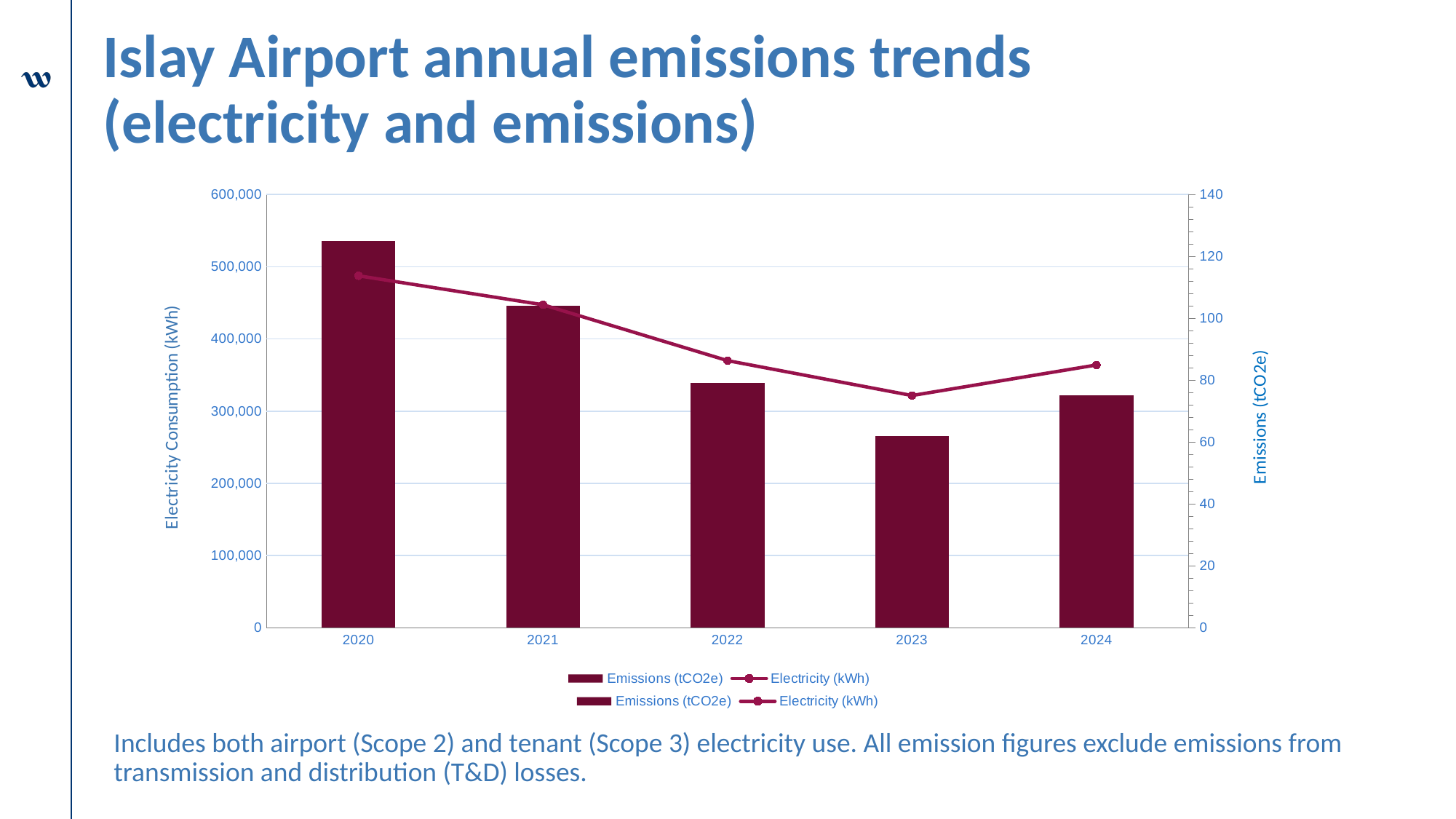
Which year has the taller bar, 2023 or 2024? 2024 Which year has the tallest bar in the chart? 2020 In which year does the line series reach its highest point? 2020 In which year does the line series reach its lowest point? 2023 What kind of chart is shown on the slide? A combined bar and line chart What is the title of the left vertical axis? Electricity Consumption (kWh) Read against the left axis, is the bar for 2020 greater or less than 500,000? greater How many years are shown on the x axis of the chart? 5 Do the bars rise or fall from 2020 to 2023? Fall Which year has the shortest bar in the chart? 2023 Which year has the taller bar, 2021 or 2022? 2021 Read against the right axis, is the line point for 2023 greater or less than 80? less